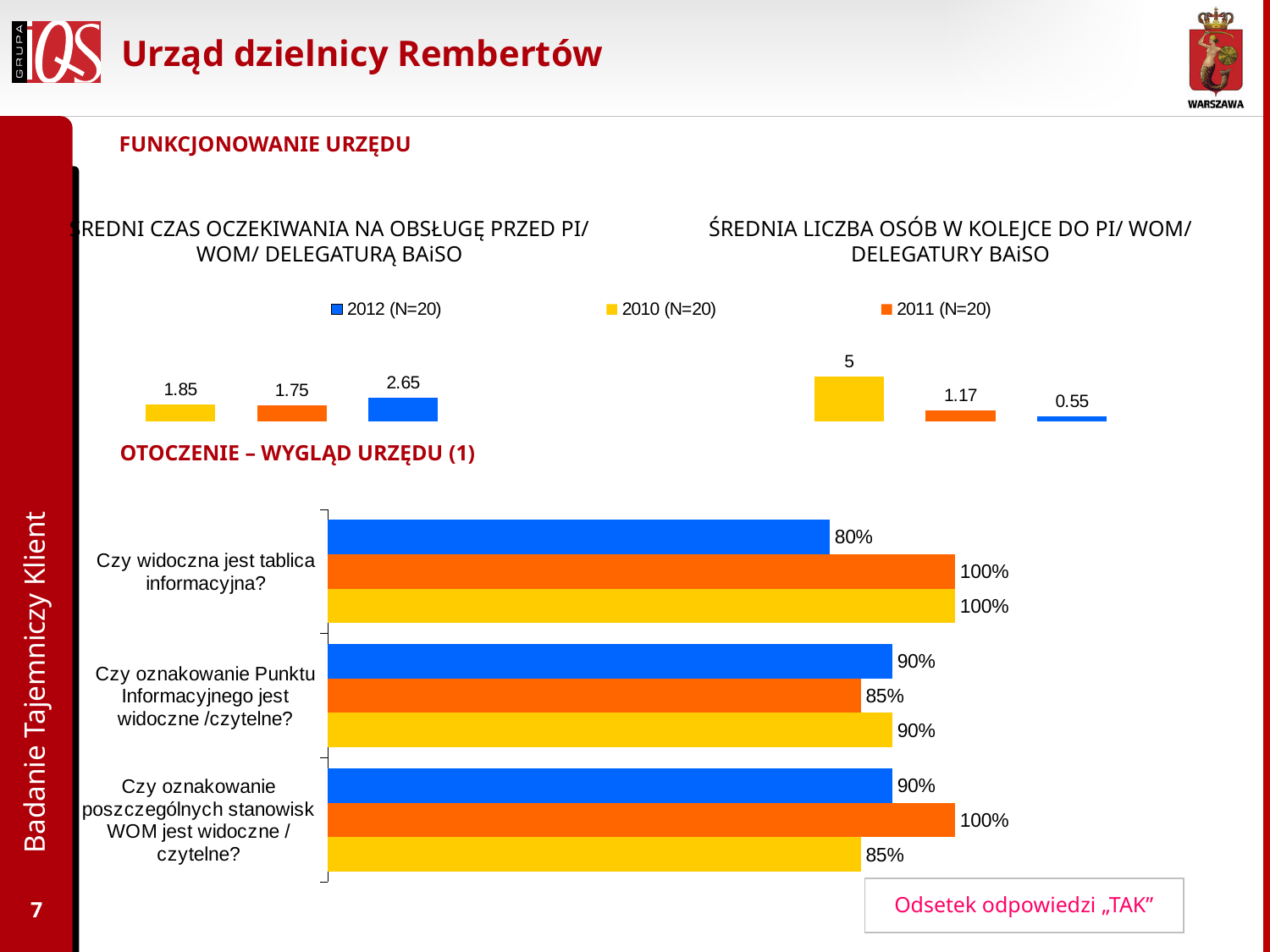
In the bottom chart 'Otoczenie – wygląd urzędu (1)', what is the 2011 (orange) value for 'Czy oznakowanie Punktu Informacyjnego jest widoczne /czytelne?'? 85% What type of chart is the bottom chart 'Otoczenie – wygląd urzędu (1)'? bar chart In the bottom chart 'Otoczenie – wygląd urzędu (1)', what is the 2012 (blue) value for 'Czy widoczna jest tablica informacyjna?'? 80% In the bottom chart 'Otoczenie – wygląd urzędu (1)', what is the difference between the 2011 (orange) and 2010 (yellow) values for 'Czy oznakowanie poszczególnych stanowisk WOM jest widoczne / czytelne?'? 15% In the chart 'Średnia liczba osób w kolejce do PI/ WOM/ Delegatury BAiSO', which year has the lowest value? 2012 In the chart 'Średni czas oczekiwania na obsługę przed PI/ WOM/ Delegaturą BAiSO', what is the difference between the 2012 and 2010 values? 0.80 How many question categories are shown in the bottom chart 'Otoczenie – wygląd urzędu (1)'? 3 In the chart 'Średnia liczba osób w kolejce do PI/ WOM/ Delegatury BAiSO', what is the value for 2010? 5 In the chart 'Średni czas oczekiwania na obsługę przed PI/ WOM/ Delegaturą BAiSO', which year has the lowest value? 2011 How many series does the legend above the top charts list? 3 In the chart 'Średnia liczba osób w kolejce do PI/ WOM/ Delegatury BAiSO', is the value for 2011 larger or smaller than the value for 2012? larger In the chart 'Średni czas oczekiwania na obsługę przed PI/ WOM/ Delegaturą BAiSO', what is the value for 2012? 2.65